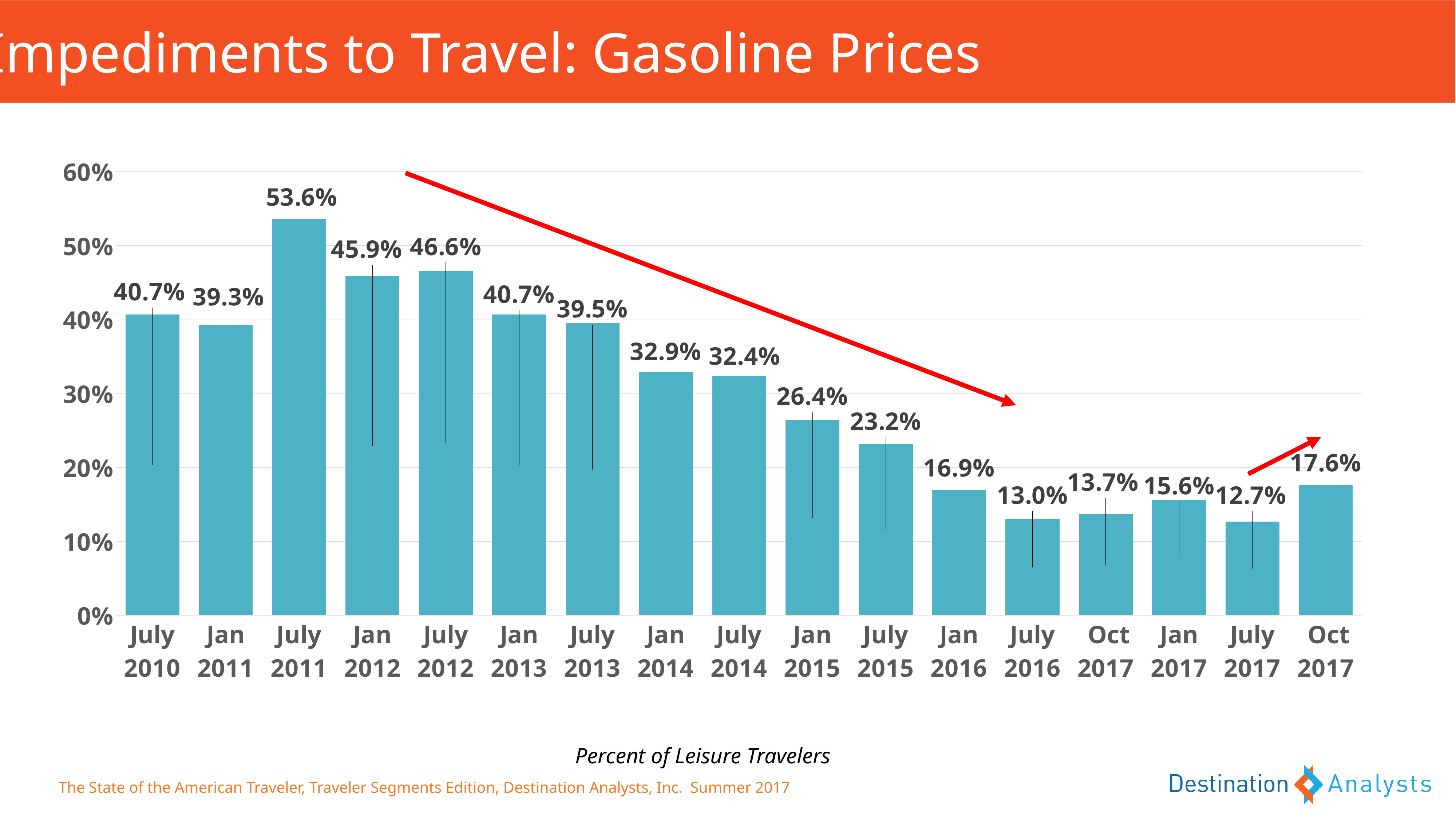
Which period has the lowest value? July 2017 What percentage of leisure travelers is shown for July 2011? 53.6% What is the difference between the July 2011 value and the Jan 2012 value? 7.7 percentage points Which is larger, the value for Jan 2012 or the value for July 2012? July 2012 What kind of chart is shown on the slide? bar chart Do the values generally rise or fall from July 2011 to July 2016? fall What is the value for Jan 2015? 26.4% What is the difference between the Jan 2016 value and the July 2016 value? 3.9 percentage points What is the value for July 2017? 12.7% Which period has the highest value? July 2011 Is the value for Jan 2014 greater or less than 30%? greater How many bars are plotted in the chart? 17